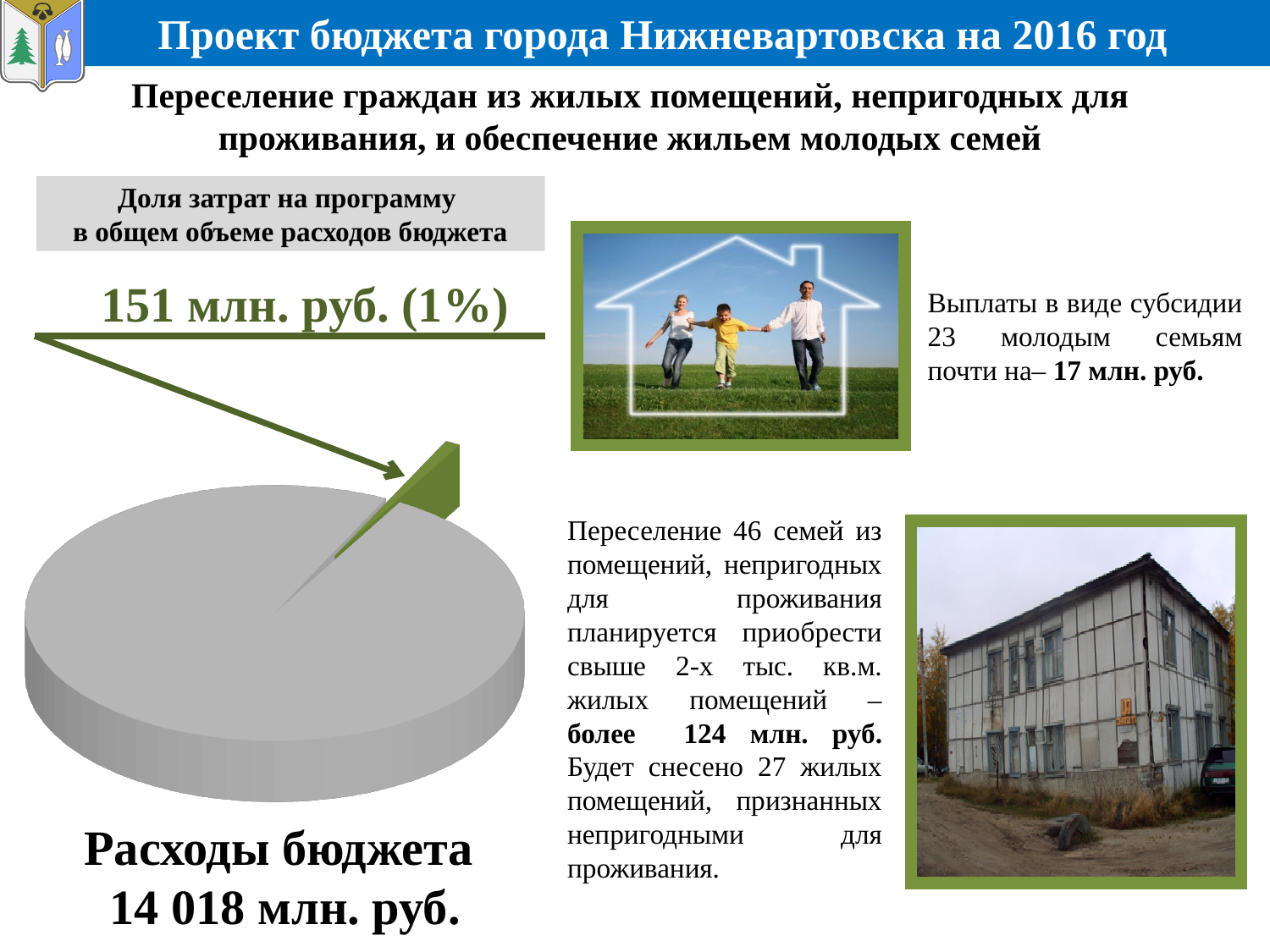
What is the total budget expenditure shown below the pie chart? 14 018 млн. руб. How many slices does the pie chart have? 2 Which slice of the pie chart is the smallest? the green slice (151 млн. руб., 1%) What kind of chart is shown on the slide? pie chart What share of the pie does the highlighted slice representing the programme costs take? 1% Is the share of the programme costs in the pie chart greater or less than 50%? less Which slice of the pie chart is larger: the green pulled-out slice or the grey remainder? the grey remainder What is the value of the highlighted (pulled-out) slice of the pie chart? 151 млн. руб. What colour is the pulled-out slice representing the programme costs? green What is the title given above the pie chart? Доля затрат на программу в общем объеме расходов бюджета